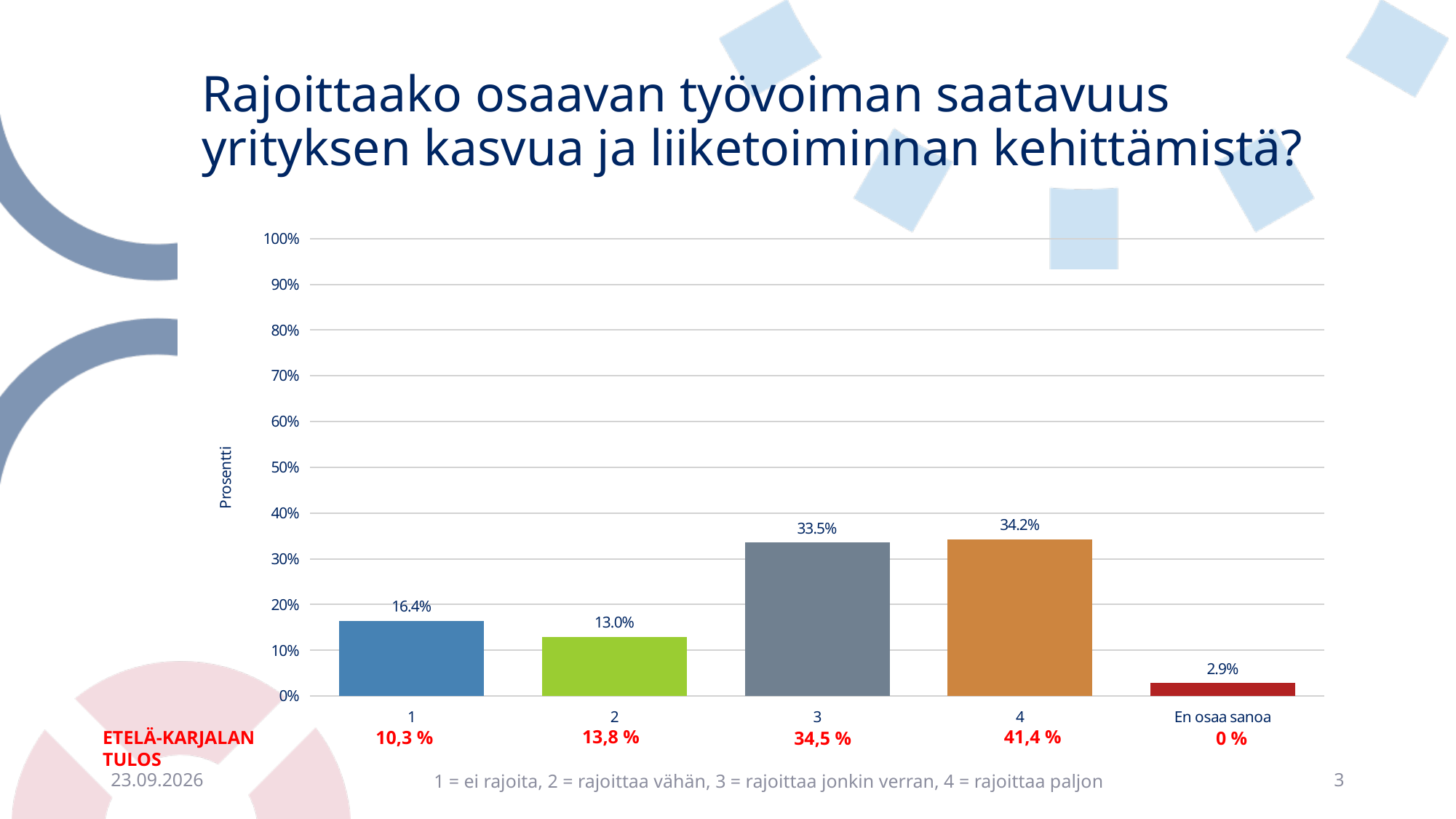
What is the difference between the values for category 4 and category 3? 0.7 percentage points Which is larger, the value for category 1 or category 2? Category 1 Is the value for category 3 greater or less than 30%? greater What is the value for category 1? 16.4% How many categories are shown on the x axis? 5 What is the value for category 3? 33.5% What is the label of the vertical axis? Prosentti What kind of chart is shown on the slide? Bar chart Which category has the lowest value? En osaa sanoa What is the difference between the values for category 1 and category 2? 3.4 percentage points Which category has the highest value? 4 What is the value for "En osaa sanoa"? 2.9%